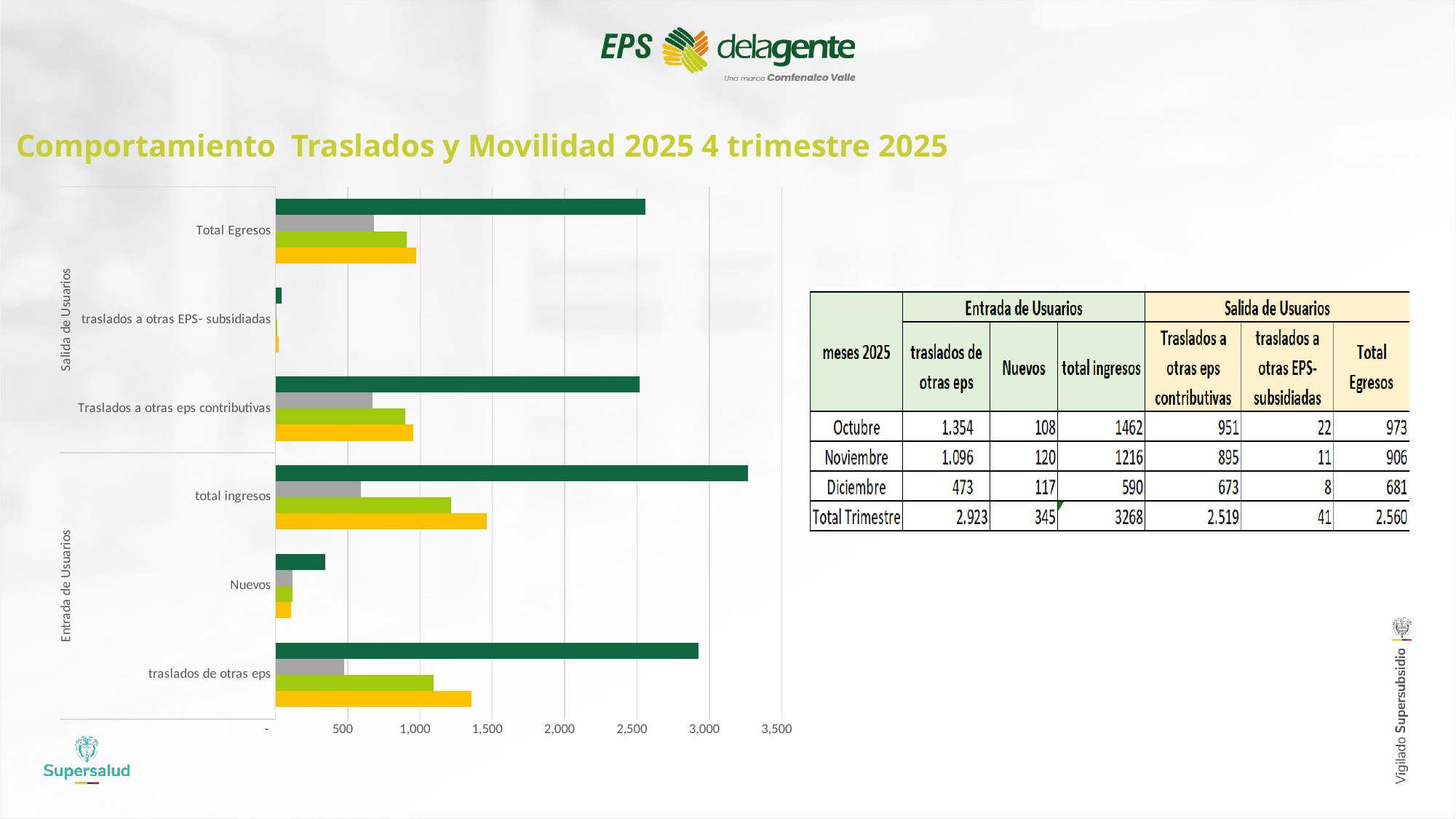
How many bars are plotted for each category in the bar chart? 4 What kind of chart is shown on the slide? bar chart Which has the longer dark green bar, Nuevos or traslados de otras eps? traslados de otras eps Is the dark green bar for total ingresos greater or less than 3,000? greater How many categories are shown on the vertical axis of the bar chart? 6 Which category has the longest dark green bar in the chart? total ingresos Is the dark green bar for traslados de otras eps greater or less than 3,000? less Is the dark green bar for Nuevos greater or less than 500? less Which has the longer dark green bar, total ingresos or Total Egresos? total ingresos What is the highest value labelled on the horizontal axis of the chart? 3,500 Which category has the shortest bars in the chart? traslados a otras EPS- subsidiadas